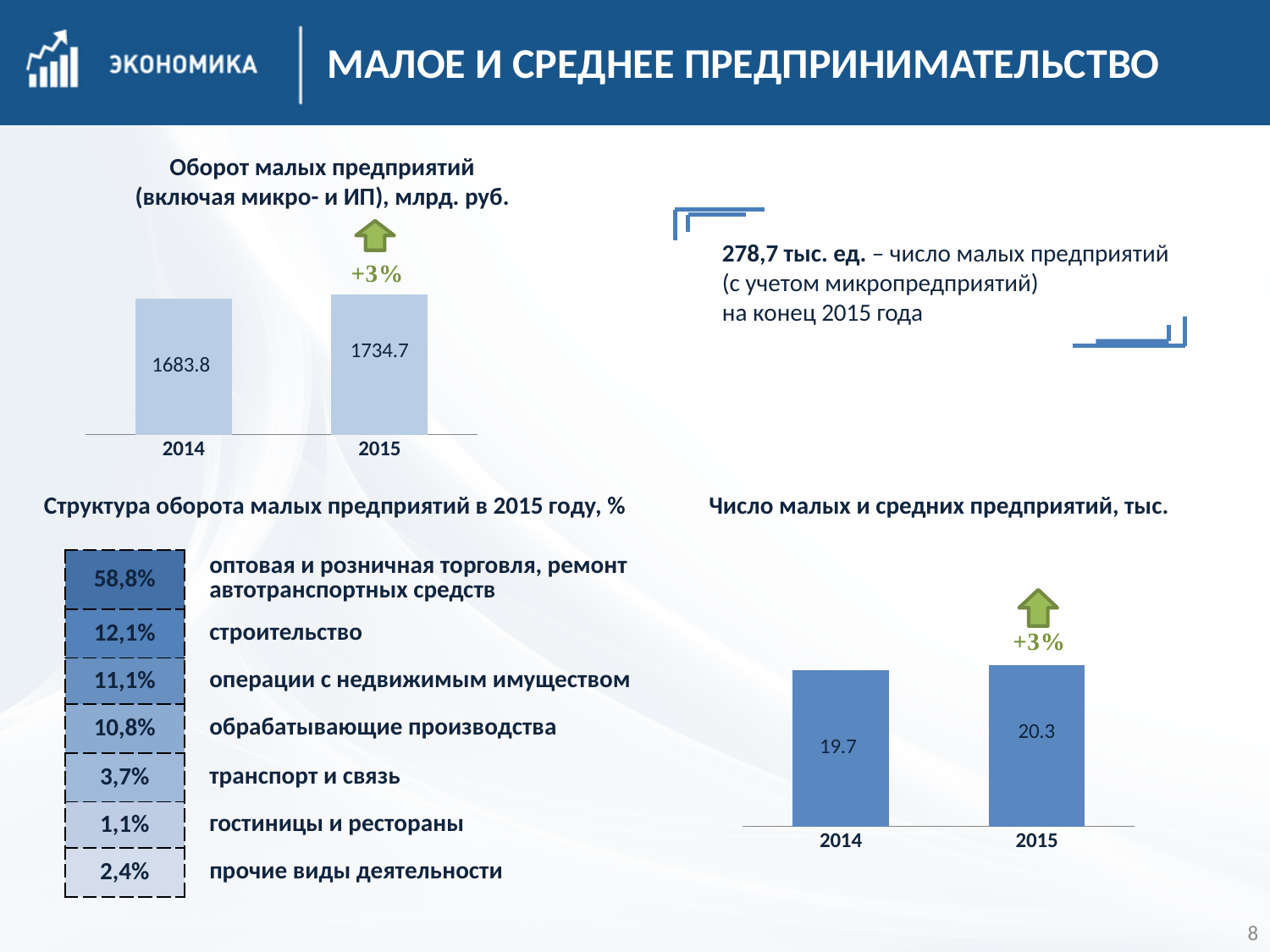
In the chart 'Оборот малых предприятий (включая микро- и ИП), млрд. руб.', what is the value for 2014? 1683.8 What type of chart is 'Число малых и средних предприятий, тыс.'? bar chart In the chart 'Оборот малых предприятий (включая микро- и ИП), млрд. руб.', which year has the higher value? 2015 In the chart 'Число малых и средних предприятий, тыс.', which year has the lower value? 2014 In the chart 'Оборот малых предприятий (включая микро- и ИП), млрд. руб.', what is the difference between the 2015 and 2014 values? 50.9 In the chart 'Число малых и средних предприятий, тыс.', what is the value for 2015? 20.3 In the chart 'Число малых и средних предприятий, тыс.', what is the value for 2014? 19.7 In the chart 'Число малых и средних предприятий, тыс.', do the values rise or fall from 2014 to 2015? rise In the chart 'Число малых и средних предприятий, тыс.', what is the difference between the 2015 and 2014 values? 0.6 How many years are shown in the chart 'Оборот малых предприятий (включая микро- и ИП), млрд. руб.'? 2 In the chart 'Оборот малых предприятий (включая микро- и ИП), млрд. руб.', what is the value for 2015? 1734.7 In the chart 'Оборот малых предприятий (включая микро- и ИП), млрд. руб.', what percentage change is shown between 2014 and 2015? +3%